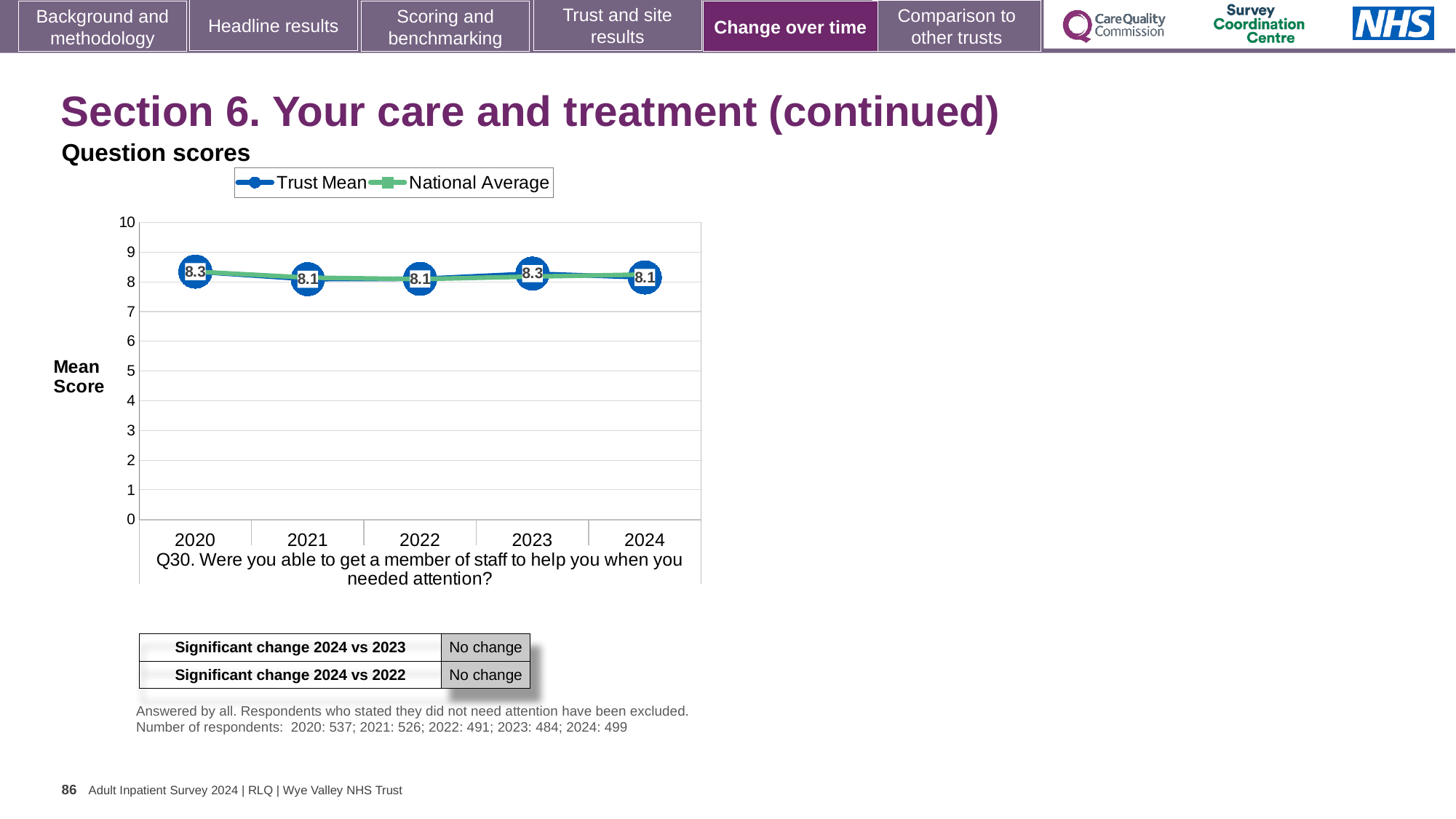
Is the National Average value for 2024 greater or less than 9? less What is the Trust Mean score for 2021? 8.1 Is the National Average value for 2022 greater or less than 7? greater Which year has the larger Trust Mean score, 2020 or 2021? 2020 What is the label on the y axis of the chart? Mean Score What is the Trust Mean score for 2024? 8.1 What kind of chart is shown on the slide? Line chart How many years are plotted on the x axis? 5 What is the Trust Mean score for 2023? 8.3 How many series does the legend list? 2 What is the difference between the Trust Mean scores for 2023 and 2024? 0.2 What is the Trust Mean score for 2020? 8.3